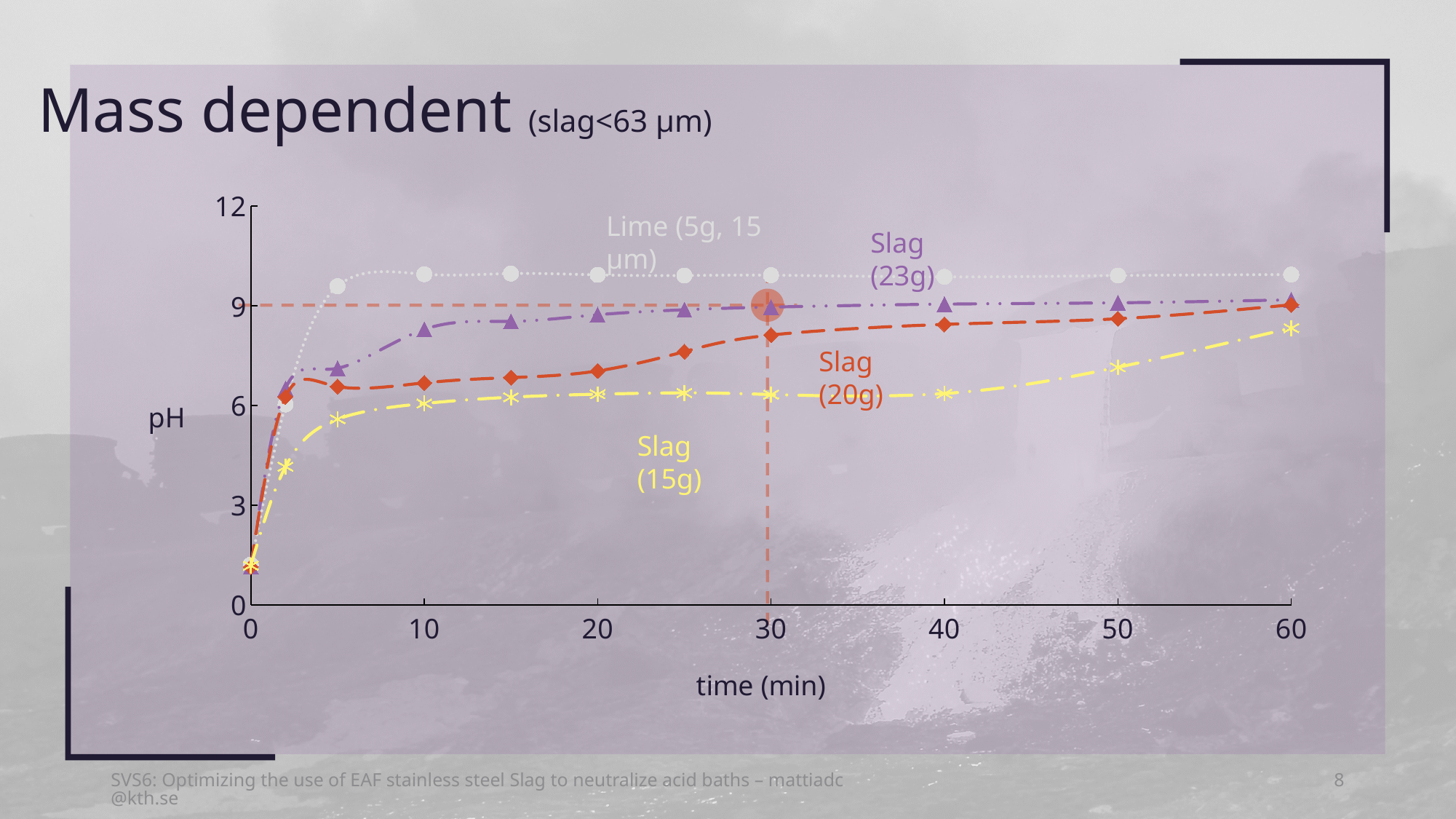
How many series are plotted on the chart? 4 At 20 min, which series has the higher pH, Slag (23g) or Slag (20g)? Slag (23g) Is the pH for Slag (20g) at 20 min greater or less than 9? less What kind of chart is shown on the slide? line chart Is the pH for Lime (5g, 15 µm) at 10 min greater or less than 9? greater Does the pH for Slag (15g) rise or fall as time increases from 0 to 60 min? rise Which series has the highest pH at 60 min? Lime (5g, 15 µm) Which series has the lowest pH at 60 min? Slag (15g) Is the pH for Slag (15g) at 5 min greater or less than 6? less What is the label of the x axis? time (min) What pH does Slag (23g) reach at 30 min, where the dashed reference lines cross? 9